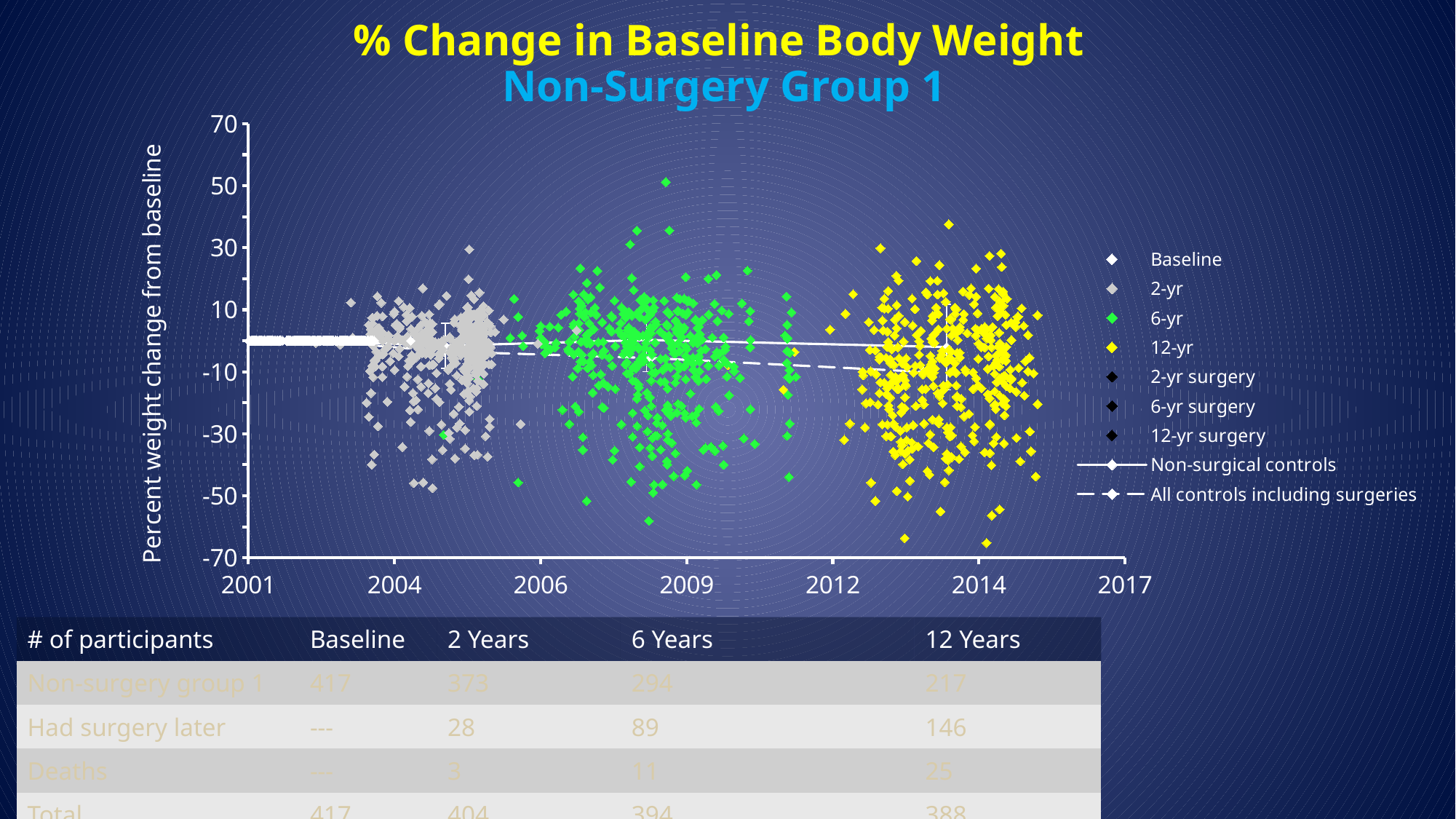
What is the first year shown on the chart's horizontal axis? 2001 What colour are the 6-yr data points in the chart? Green What is the highest value shown on the chart's vertical axis? 70 What is the label of the chart's vertical axis? Percent weight change from baseline Which series appears latest along the horizontal axis: 2-yr, 6-yr or 12-yr? 12-yr What is the last year shown on the chart's horizontal axis? 2017 Is the highest 12-yr data point greater or less than 30? greater What is the title of the chart? % Change in Baseline Body Weight Is the lowest 12-yr data point greater or less than -50? less Does the dashed 'All controls including surgeries' line rise or fall as the years increase? Fall What kind of chart is shown on the slide? Scatter chart How many entries does the chart's legend list? 9